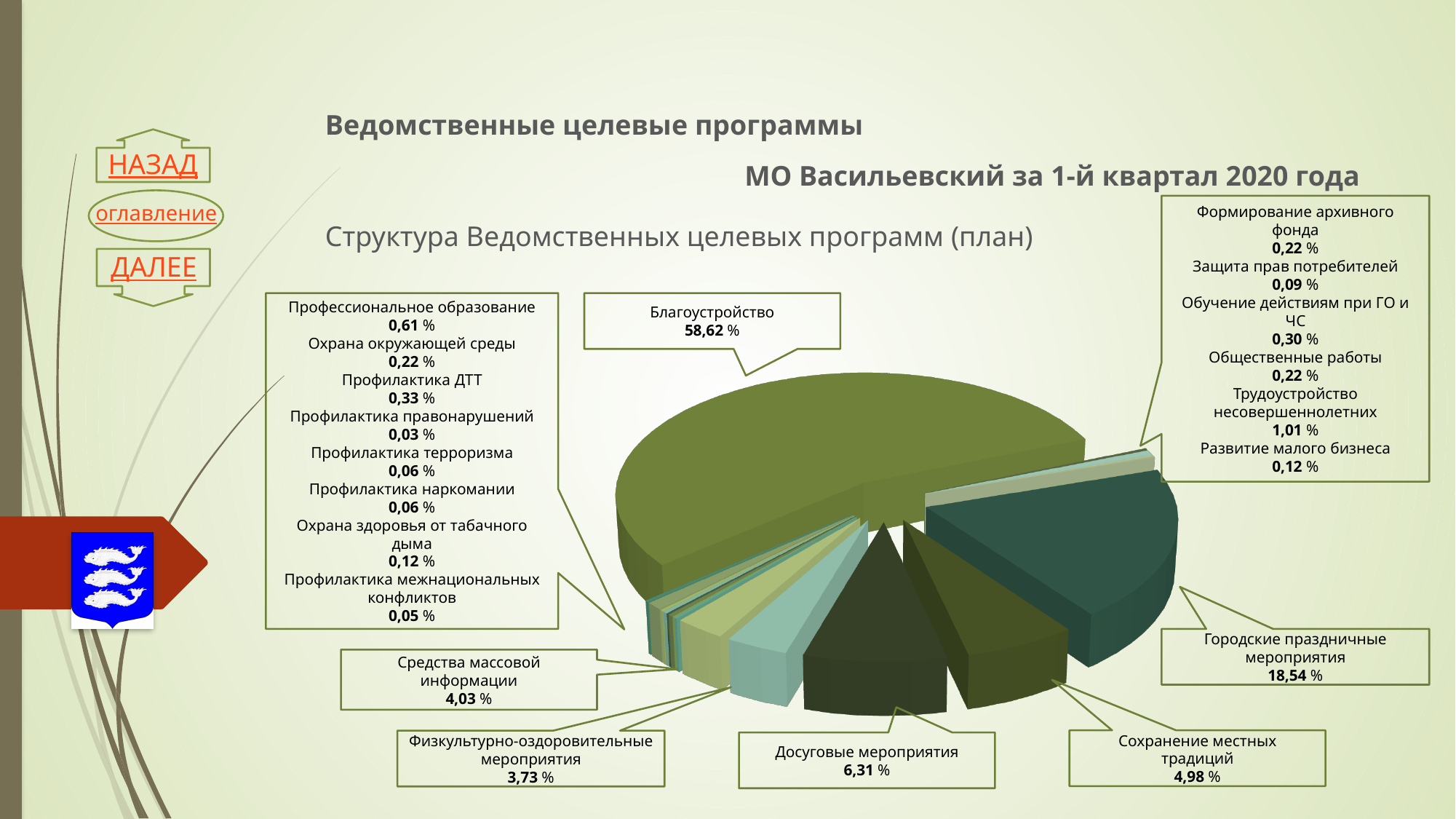
What is the value for Досуговые мероприятия? 6,31 % What is the value for Трудоустройство несовершеннолетних? 1,01 % What is the difference between the shares of Благоустройство and Городские праздничные мероприятия? 40,08 % How many categories are labelled on the pie chart? 20 What kind of chart is shown on the slide? Pie chart What is the title of the chart? Структура Ведомственных целевых программ (план) What is the difference between the shares of Средства массовой информации and Физкультурно-оздоровительные мероприятия? 0,30 % Which category has the smallest share of the pie? Профилактика правонарушений Which category has the largest share of the pie? Благоустройство What is the value for Городские праздничные мероприятия? 18,54 % What share does Благоустройство have in the pie chart? 58,62 % Which is larger: Досуговые мероприятия or Сохранение местных традиций? Досуговые мероприятия